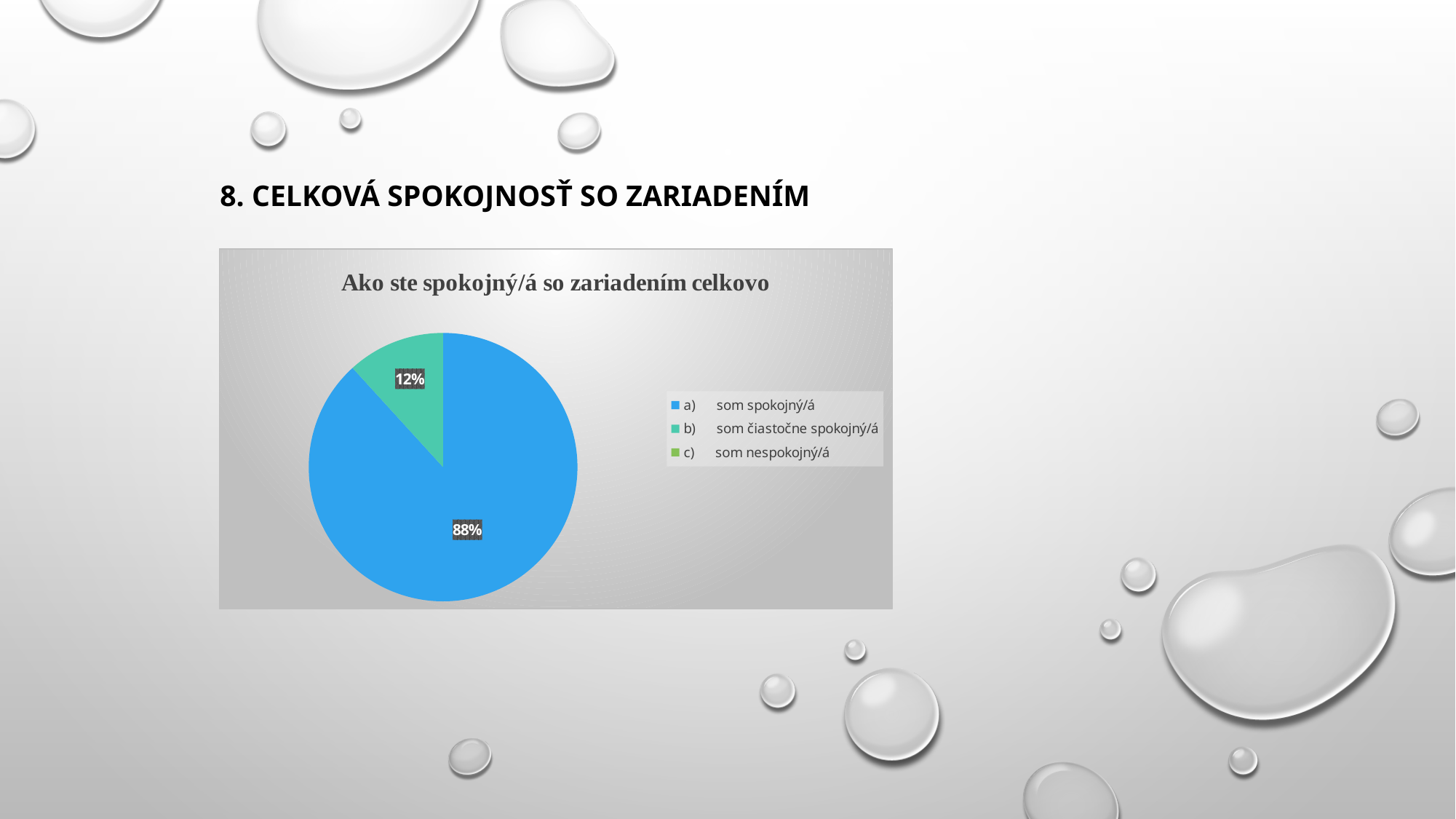
What share of the pie is labelled for "a) som spokojný/á"? 88% What is the chart's title? Ako ste spokojný/á so zariadením celkovo How many entries does the legend list? 3 Which of the two labelled slices is smaller, "a) som spokojný/á" or "b) som čiastočne spokojný/á"? b) som čiastočne spokojný/á What kind of chart is shown on the slide? pie chart What is the difference in percentage points between the "a) som spokojný/á" slice and the "b) som čiastočne spokojný/á" slice? 76 What share of the pie is labelled for "b) som čiastočne spokojný/á"? 12% Which category has the largest slice of the pie? a) som spokojný/á What colour is the slice for "a) som spokojný/á"? blue Is the share for "a) som spokojný/á" greater or less than 50%? greater How many slices with a printed percentage label are visible in the pie? 2